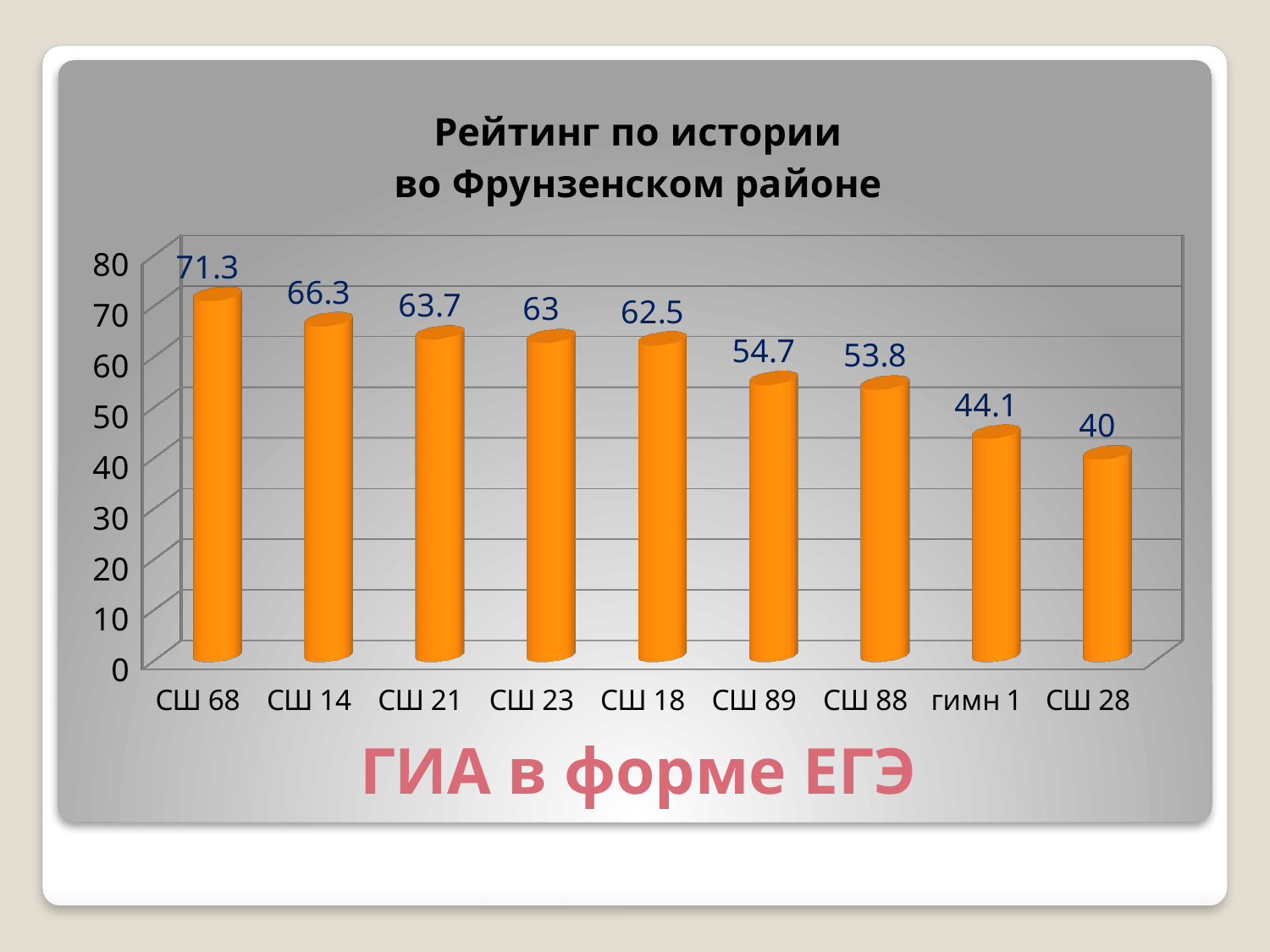
What is the difference between the values for СШ 14 and СШ 88? 12.5 Which category has the highest value? СШ 68 What kind of chart is shown on the slide? bar chart Which is larger, the value for СШ 21 or the value for СШ 18? СШ 21 Is the value for СШ 88 greater or less than 50? greater What is the value for СШ 89? 54.7 What is the difference between the values for СШ 68 and СШ 28? 31.3 What is the value for СШ 68? 71.3 Do the values rise or fall from left to right along the x axis? fall Which category has the lowest value? СШ 28 How many categories are shown on the x axis? 9 What is the value for гимн 1? 44.1